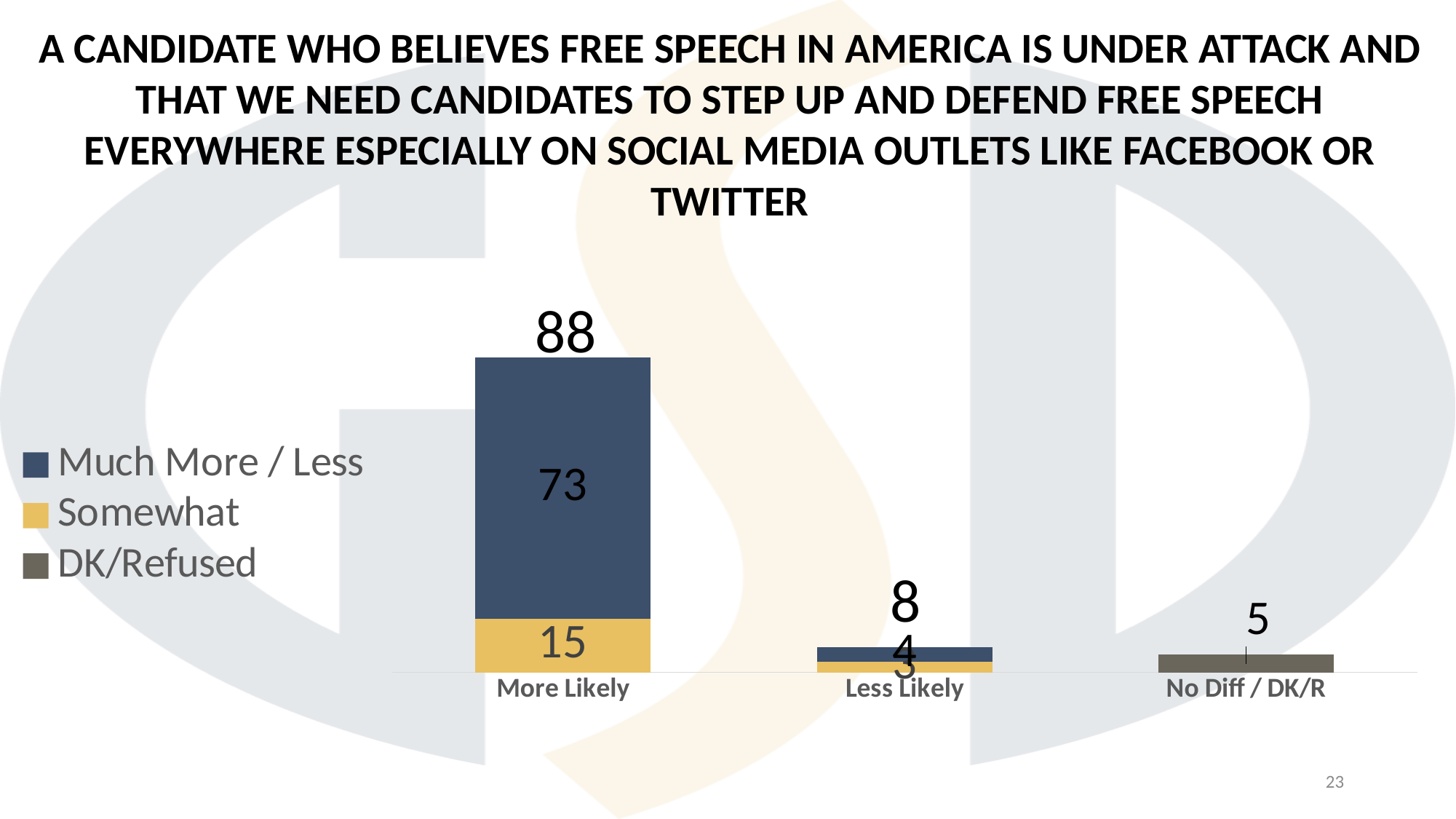
What is the total value shown above the More Likely bar? 88 What is the value for No Diff / DK/R? 5 Which category has the lowest total? No Diff / DK/R What is the Somewhat value for More Likely? 15 What is the Much More / Less value for Less Likely? 4 What is the Much More / Less value for More Likely? 73 What is the difference between the Much More / Less value and the Somewhat value for More Likely? 58 Which is larger: the total for Less Likely or the value for No Diff / DK/R? Less Likely Which category has the highest total? More Likely How many categories are shown on the x axis? 3 What is the total value shown above the Less Likely bar? 8 How many series does the legend list? 3